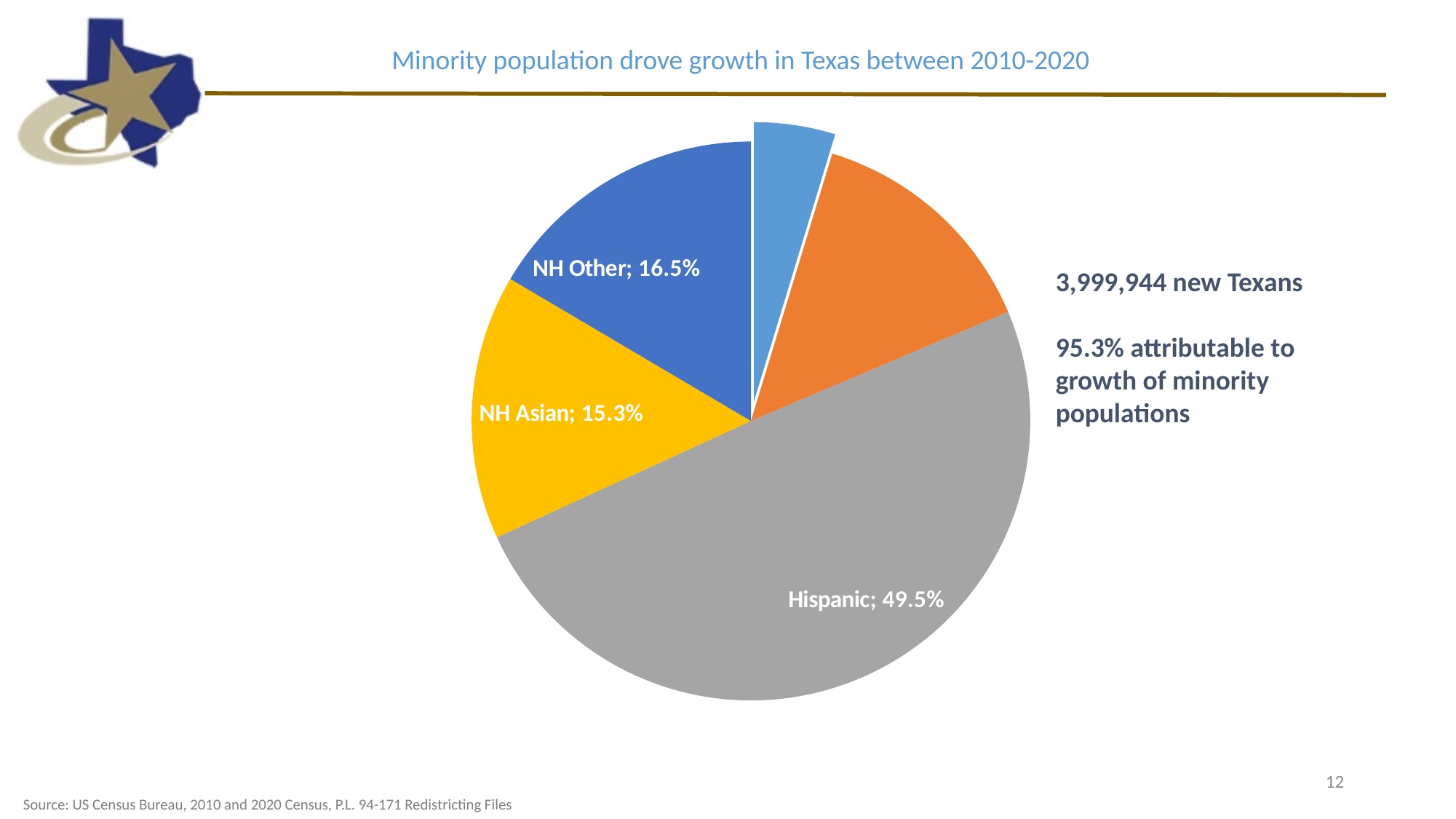
What is the title of the slide containing the pie chart? Minority population drove growth in Texas between 2010-2020 What colour is the Hispanic slice of the pie chart? grey How many slices of the pie chart have a printed label with a value? 3 How many slices does the pie chart have? 5 What share of the pie does the Hispanic slice represent? 49.5% Which is larger, the NH Other slice or the NH Asian slice? NH Other What is the value shown for NH Other? 16.5% What is the value shown for NH Asian? 15.3% What kind of chart is shown on the slide? pie chart What is the difference in percentage points between NH Other and NH Asian? 1.2 percentage points What is the difference in percentage points between Hispanic and NH Other? 33.0 percentage points Which labeled category has the largest slice of the pie? Hispanic